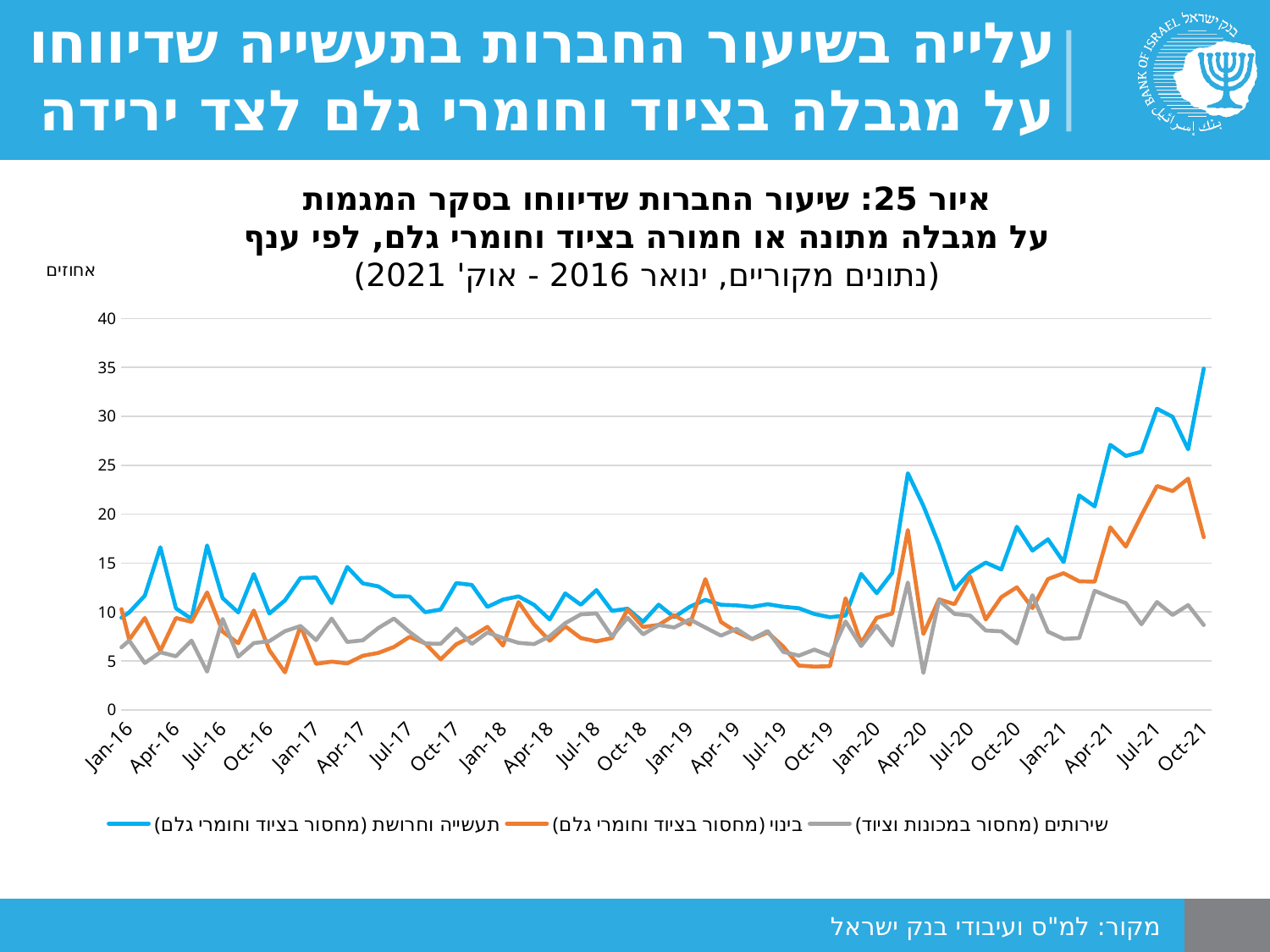
How many series does the legend list? 3 Is the value for שירותים at Apr-20 greater or less than 20? less What kind of chart is shown on the slide? line chart What unit label is shown above the y axis? אחוזים Which series reaches the highest value on the chart? תעשייה וחרושת (מחסור בציוד וחומרי גלם) Which series has the higher value at Oct-21, שירותים or תעשייה וחרושת? תעשייה וחרושת Which series has the higher value at Apr-20, תעשייה וחרושת or בינוי? תעשייה וחרושת Does the שירותים series rise or fall between Jan-21 and Oct-21? rise Which series is plotted in blue? תעשייה וחרושת (מחסור בציוד וחומרי גלם) Is the value for בינוי at Apr-20 greater or less than 5? greater Is the value for תעשייה וחרושת at Oct-21 greater or less than 15? greater